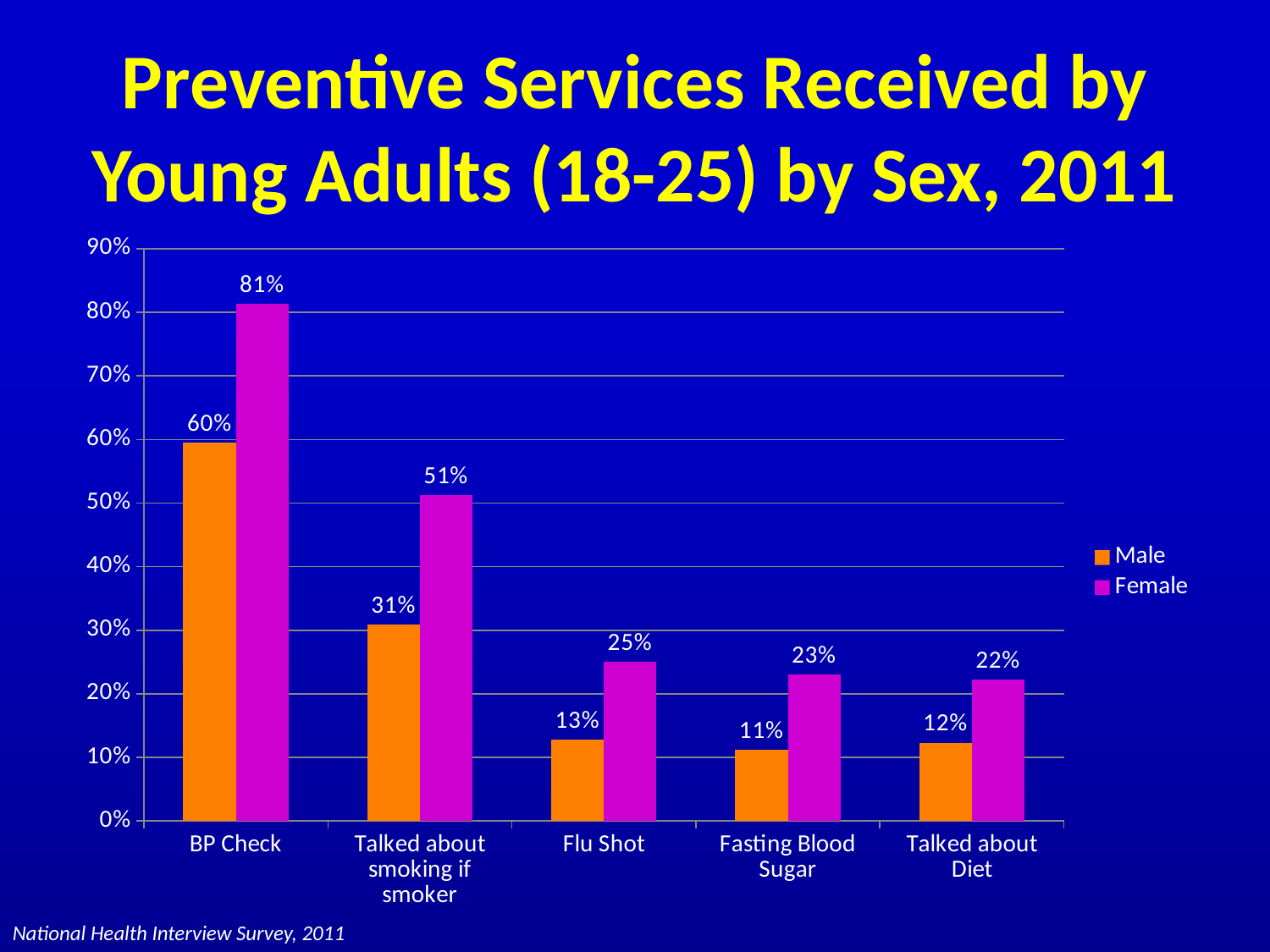
What is the Male value for Fasting Blood Sugar? 11% How many preventive service categories are shown on the x axis? 5 What percentage of young adult males received a Flu Shot? 13% Which preventive service has the highest value for females? BP Check What colour represents the Female series in the chart? Magenta Which is larger, the Female value for Flu Shot or the Female value for Talked about Diet? Female value for Flu Shot Which preventive service has the lowest value for males? Fasting Blood Sugar What is the difference between the Female and Male values for Talked about smoking if smoker? 20% How many series does the legend list? 2 What is the difference between the Female and Male values for BP Check? 21% What percentage of young adult females received a BP Check? 81% What kind of chart is shown on the slide? Bar chart